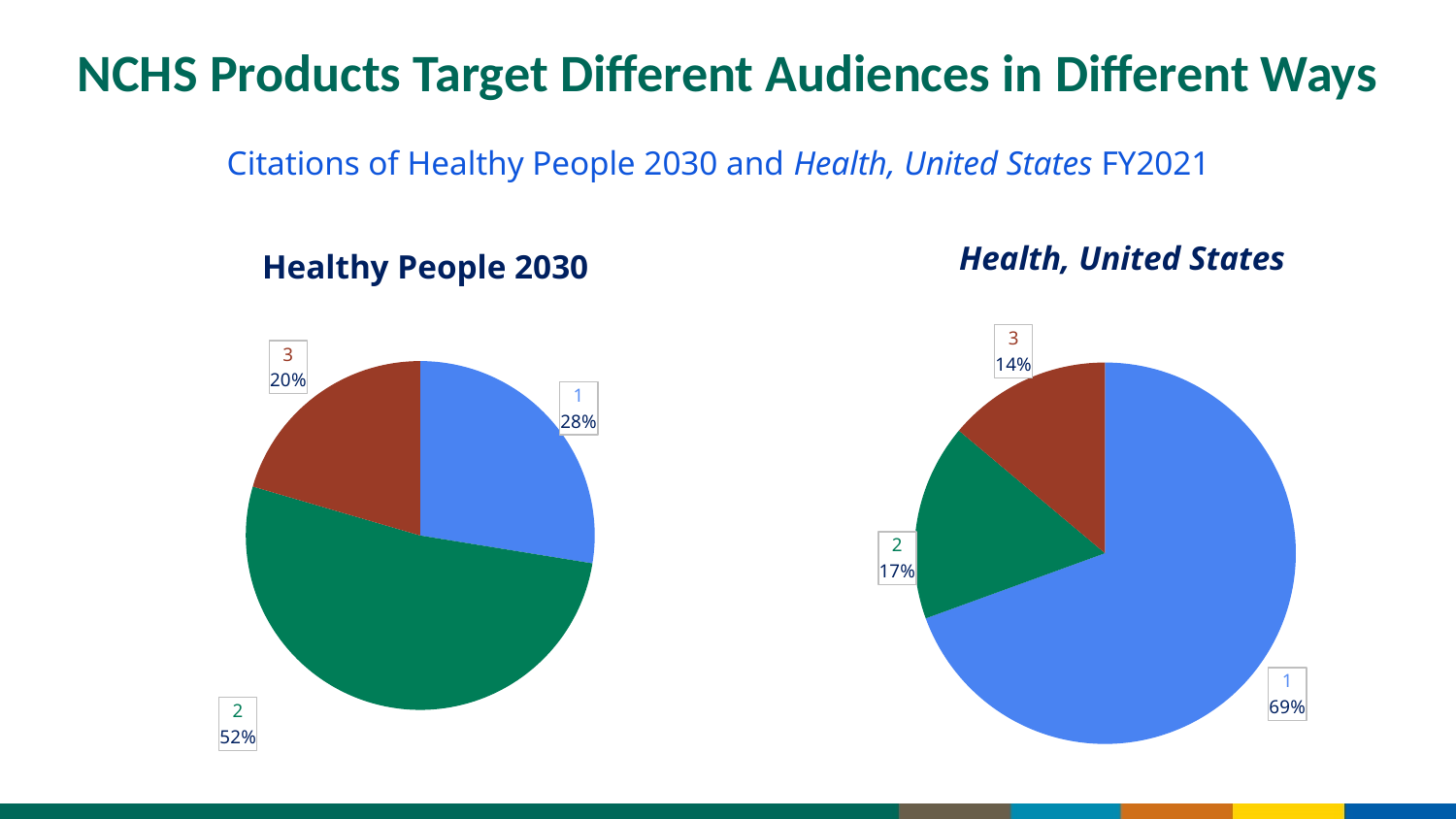
In the Health, United States chart, what share does slice 1 have? 69% What type of chart is the Healthy People 2030 chart? Pie chart In the Health, United States chart, what share does slice 2 have? 17% How many slices does the Health, United States chart have? 3 In the Healthy People 2030 chart, what share does slice 1 have? 28% In the Health, United States chart, which is larger, slice 2 or slice 3? 2 In the Health, United States chart, which slice is the smallest? 3 In the Healthy People 2030 chart, what share does slice 2 have? 52% In the Health, United States chart, what share does slice 3 have? 14% In the Healthy People 2030 chart, which slice is the largest? 2 In the Healthy People 2030 chart, what is the difference in percentage points between slice 2 and slice 1? 24 In the Healthy People 2030 chart, what share does slice 3 have? 20%